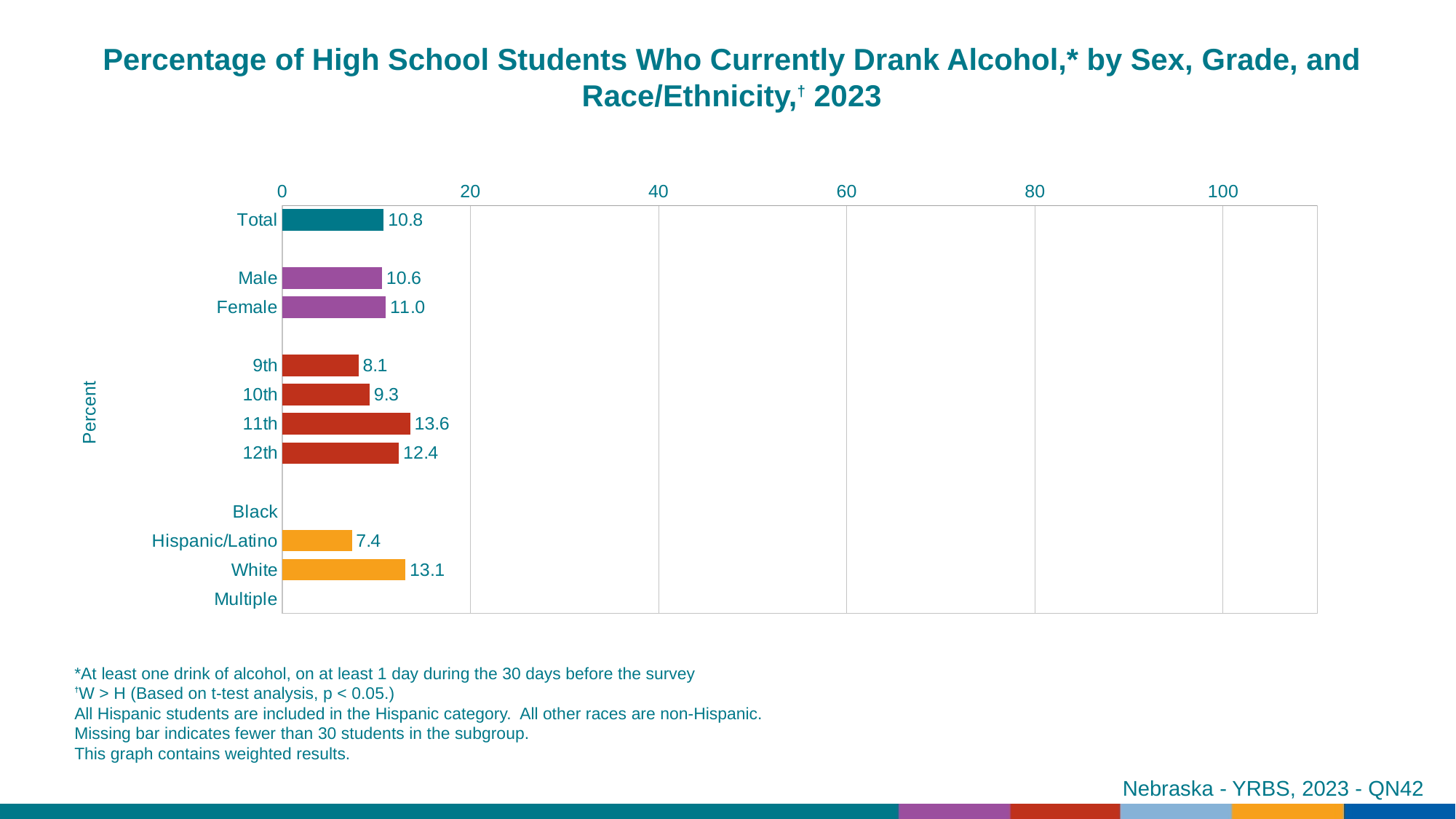
What is the value for 11th grade? 13.6 What kind of chart is this? bar chart Which is larger, the value for White or the value for Hispanic/Latino? White Which grade has the highest value? 11th Which race/ethnicity categories have no bar shown? Black and Multiple Which grade has the lowest value? 9th What is the value for Hispanic/Latino? 7.4 Is the value for 12th grade greater or less than 20? less What is the value for Female? 11.0 What is the difference between the values for 11th and 9th grade? 5.5 How many categories have a bar plotted? 9 What is the value for Total? 10.8